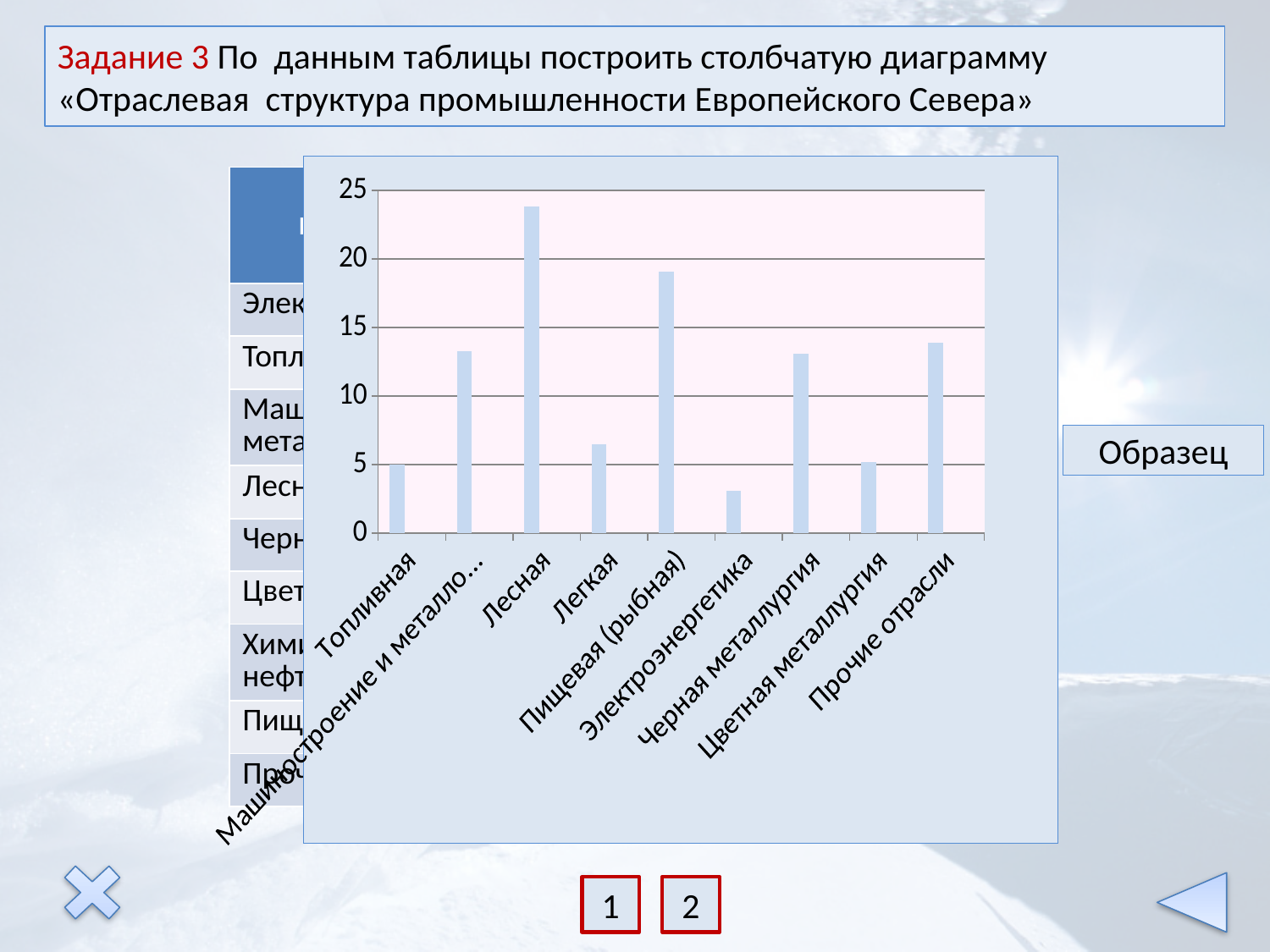
Is the value for Лесная greater or less than 20? greater What kind of chart is shown on the slide? bar chart Which is larger, the value for Легкая or the value for Пищевая (рыбная)? Пищевая (рыбная) What is the highest value shown on the vertical axis of the chart? 25 Which is larger, the value for Лесная or the value for Пищевая (рыбная)? Лесная Which category has the lowest bar? Электроэнергетика Which category has the highest bar? Лесная Is the value for Электроэнергетика greater or less than 5? less Is the value for Прочие отрасли greater or less than 10? greater How many categories are plotted on the chart? 9